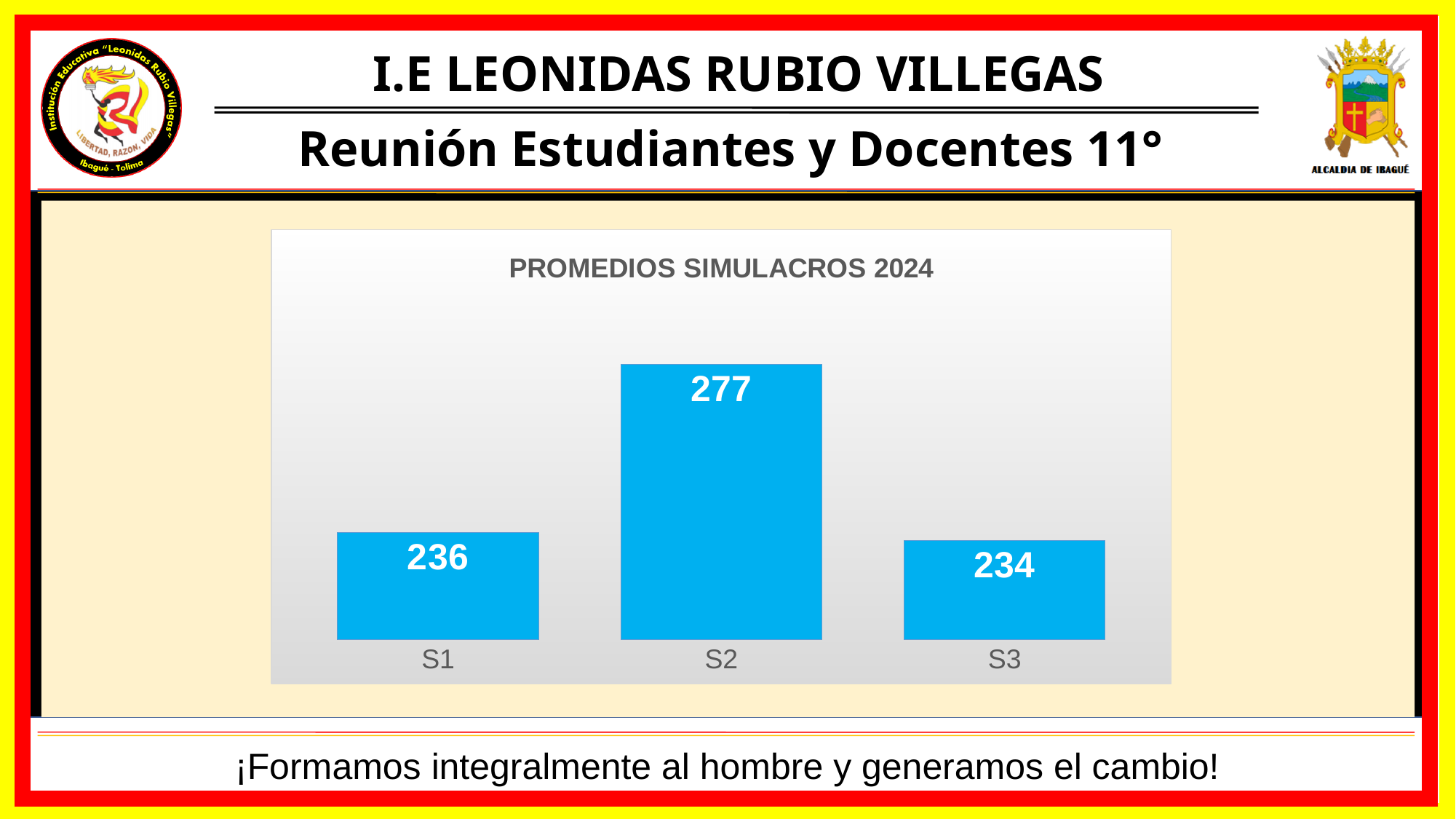
What is the value for S2? 277 What is the value for S1? 236 What is the difference between the values for S2 and S3? 43 Which is larger, the value for S2 or the value for S3? S2 Which category has the highest value? S2 What kind of chart is shown on the slide? bar chart What is the difference between the values for S1 and S3? 2 What is the title of the chart? PROMEDIOS SIMULACROS 2024 Which category has the lowest value? S3 What is the value for S3? 234 What is the difference between the values for S2 and S1? 41 How many categories are shown in the chart? 3